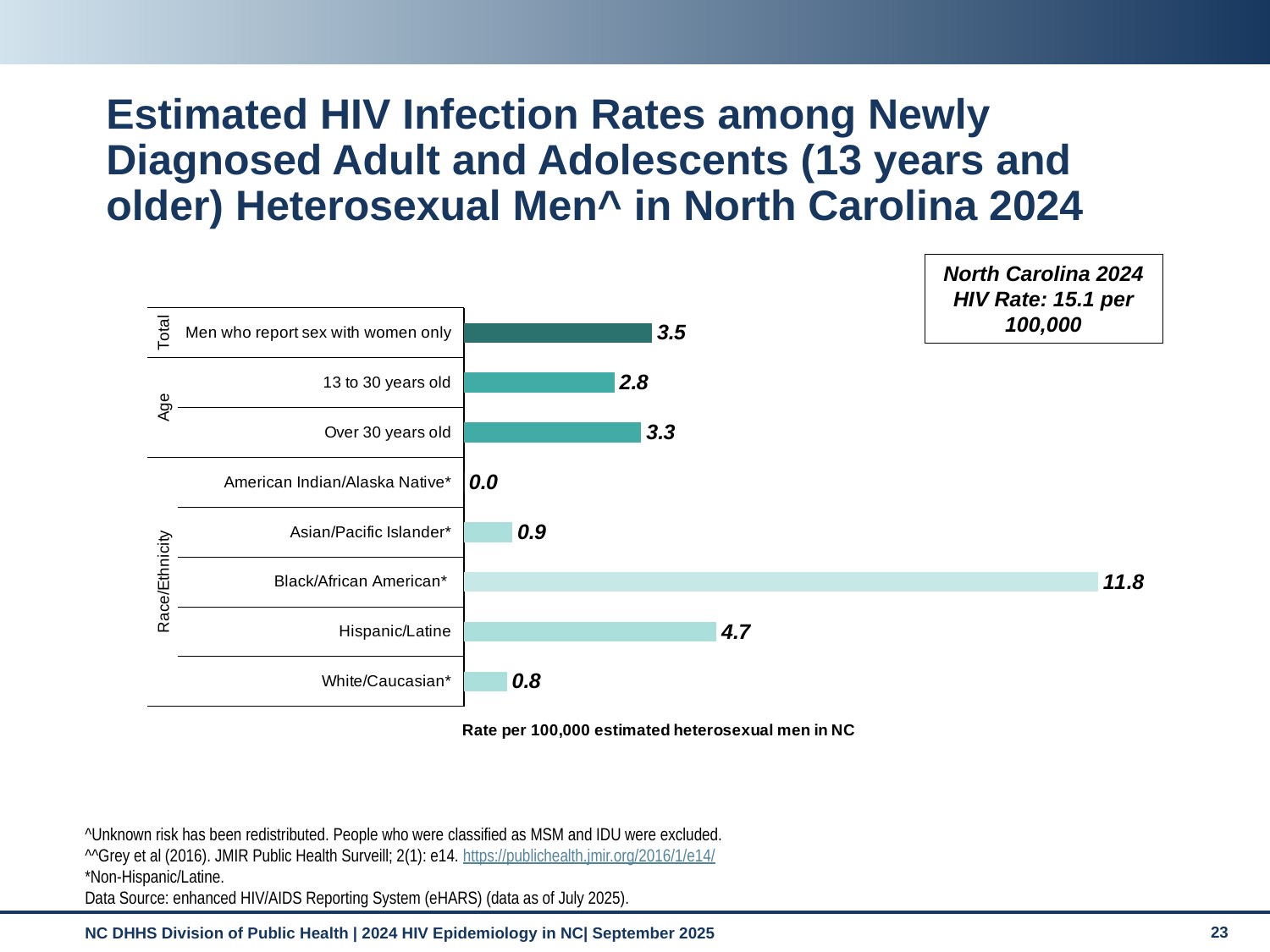
Which has a higher rate, Asian/Pacific Islander* or White/Caucasian*? Asian/Pacific Islander* Which category has the lowest rate on the chart? American Indian/Alaska Native* What is the overall North Carolina 2024 HIV rate shown in the text box? 15.1 per 100,000 Which race/ethnicity category has the highest rate? Black/African American* How many categories are plotted on the chart? 8 What is the rate for men who report sex with women only (Total)? 3.5 What is the rate for Hispanic/Latine heterosexual men? 4.7 What kind of chart is shown on the slide? Bar chart What is the difference between the rates for Black/African American* and Hispanic/Latine? 7.1 What is the rate for Black/African American* heterosexual men? 11.8 What is the difference between the rates for Over 30 years old and 13 to 30 years old? 0.5 What is the rate for the 13 to 30 years old group? 2.8